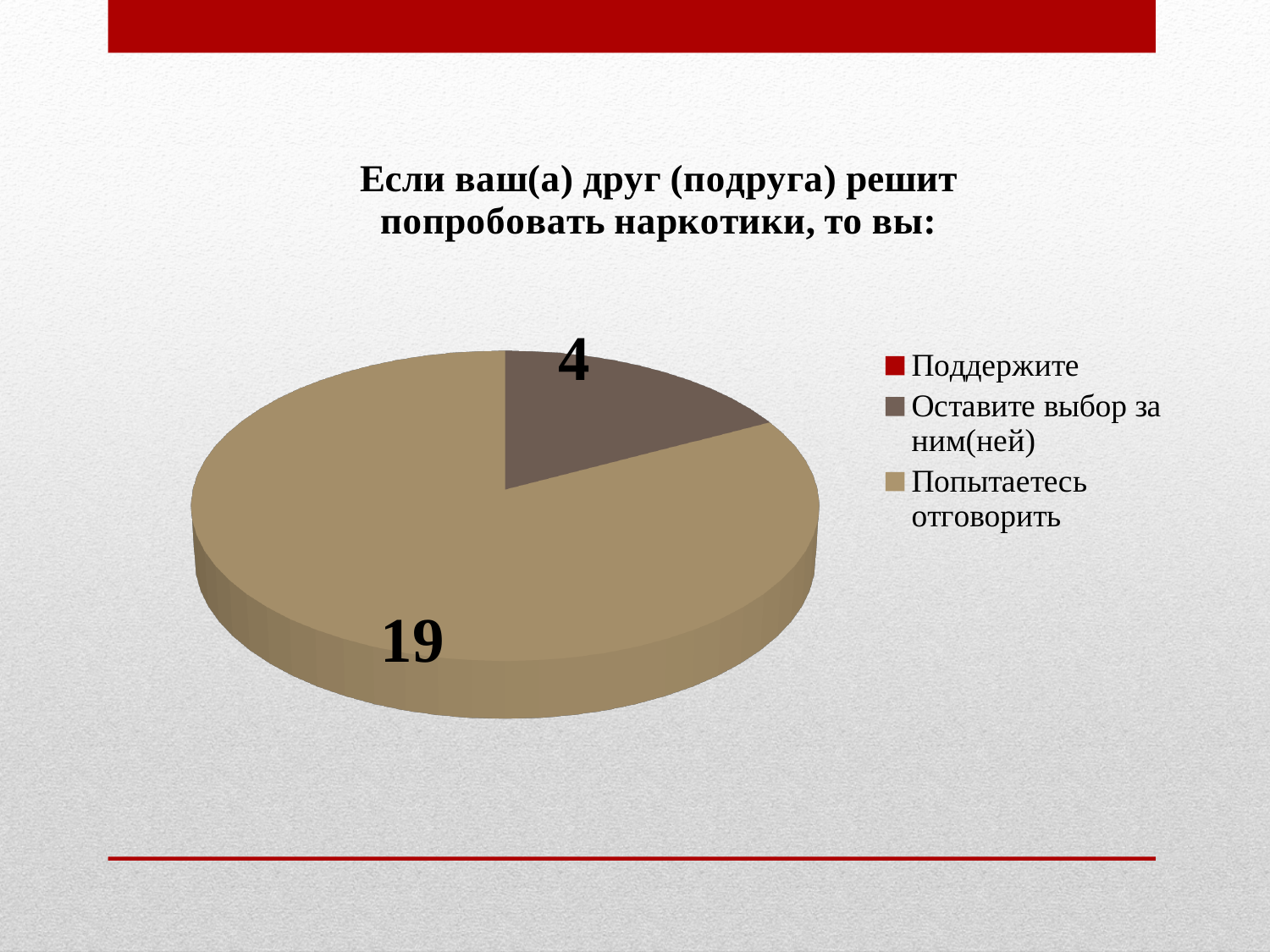
What is the difference between the values for 'Попытаетесь отговорить' and 'Оставите выбор за ним(ней)'? 15 Which is larger: 'Оставите выбор за ним(ней)' or 'Попытаетесь отговорить'? Попытаетесь отговорить Which category has the largest slice of the pie? Попытаетесь отговорить What kind of chart is shown on the slide? Pie chart What value is shown for the slice 'Оставите выбор за ним(ней)'? 4 Which legend entry is shown in red? Поддержите How many entries does the legend list? 3 What value is shown for the slice 'Попытаетесь отговорить'? 19 What is the title of the chart? Если ваш(а) друг (подруга) решит попробовать наркотики, то вы: